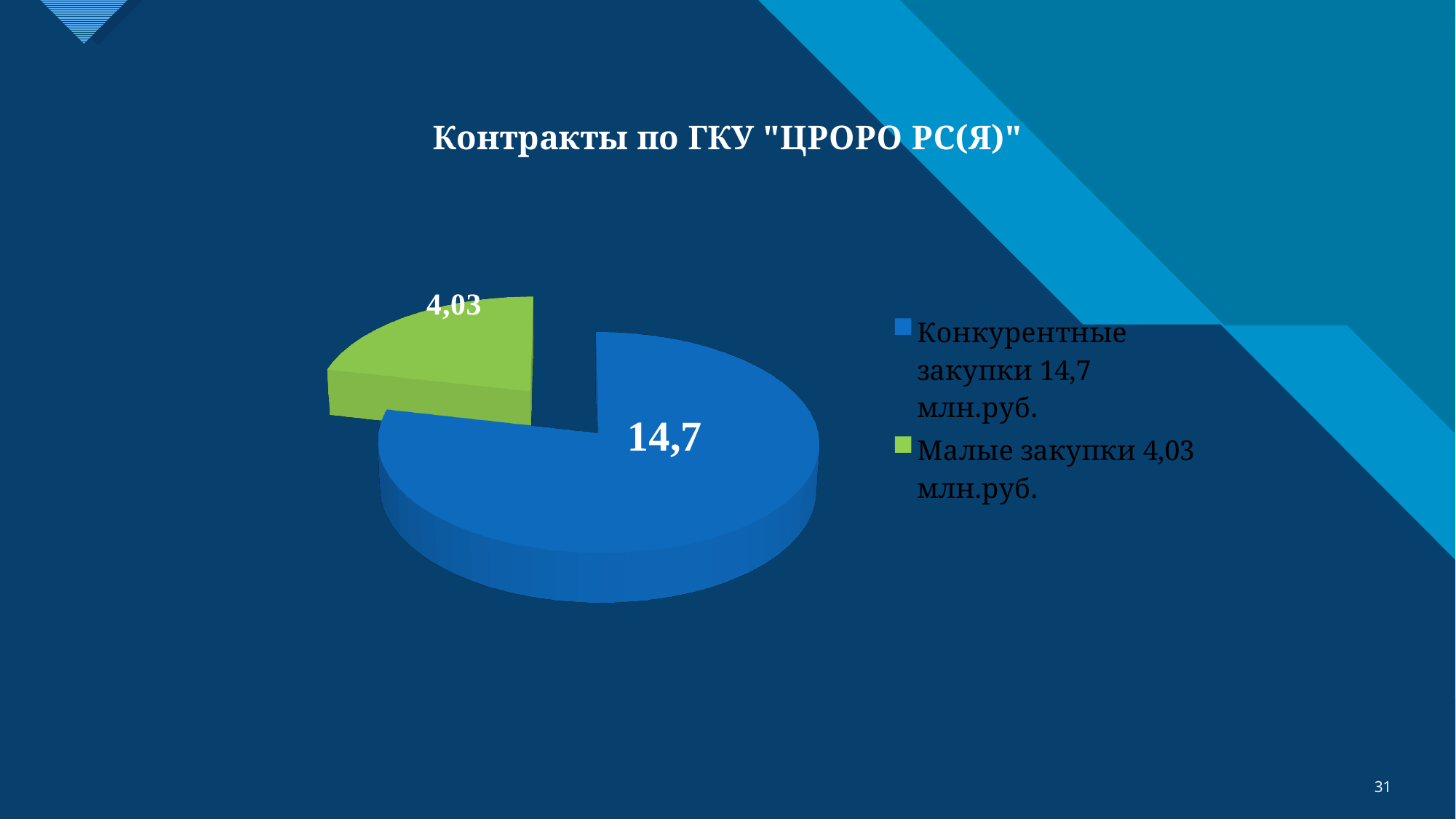
What is the title of the chart? Контракты по ГКУ "ЦРОРО РС(Я)" What is the value shown for Малые закупки? 4,03 Which is larger, Конкурентные закупки or Малые закупки? Конкурентные закупки What is the value shown for Конкурентные закупки? 14,7 What colour is the slice for Малые закупки? Green How many slices does the pie chart have? 2 Which category has the largest slice of the pie? Конкурентные закупки What kind of chart is shown on the slide? Pie chart Which category has the smallest slice of the pie? Малые закупки How many entries does the legend list? 2 What is the total of the two values shown in the pie chart? 18,73 What is the difference between the values for Конкурентные закупки and Малые закупки? 10,67